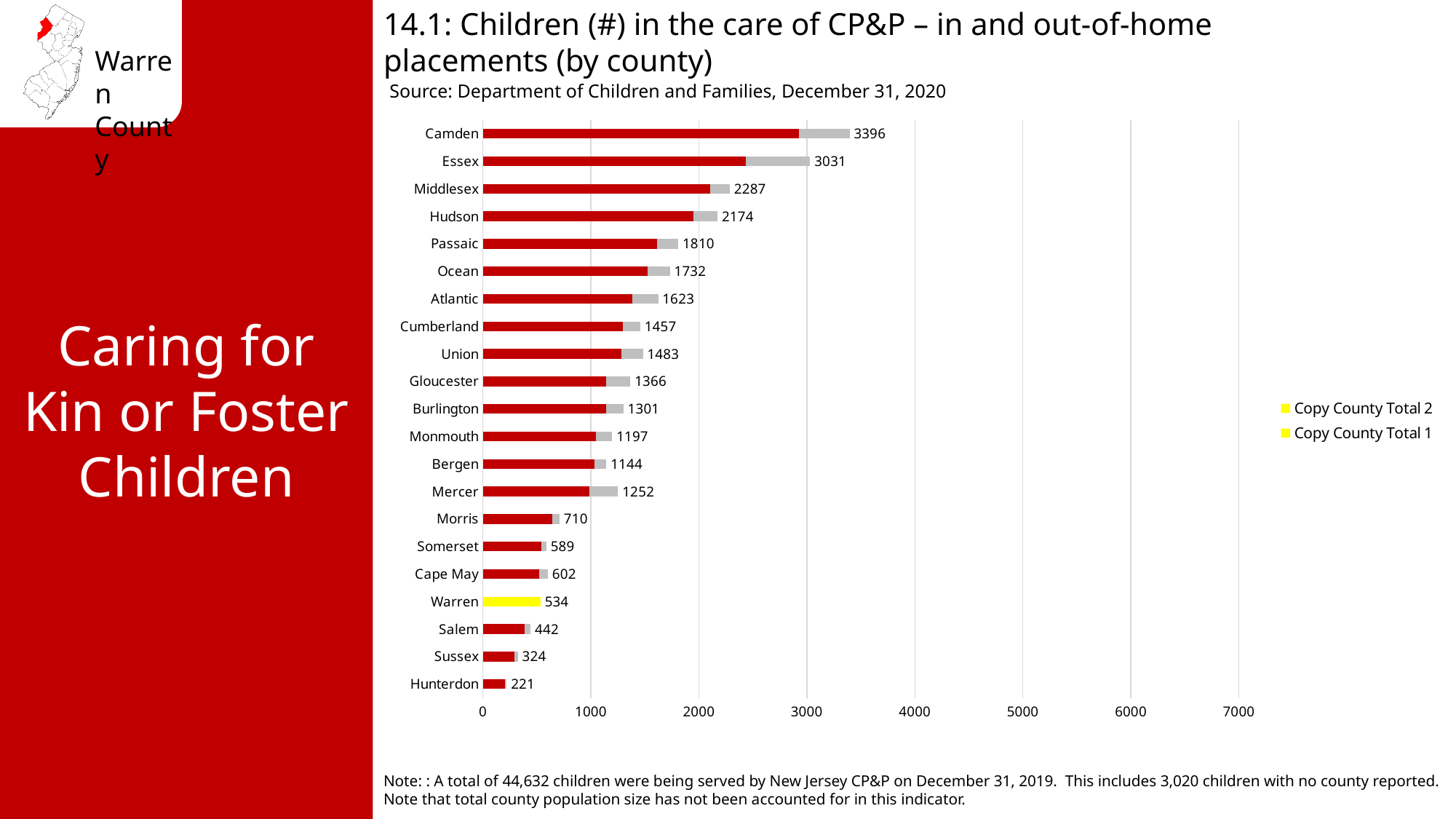
Is the red (first) segment of the Camden bar greater or less than 2000? greater Which has the larger labelled total, Union or Cumberland? Union How many series does the legend list? 2 What value is labelled for Mercer? 1252 Which county has the highest total number of children in the care of CP&P? Camden What kind of chart is shown on the slide? Bar chart What is the difference between the totals for Camden and Essex? 365 Which has the larger labelled total, Mercer or Bergen? Mercer Which county has the lowest total number of children in the care of CP&P? Hunterdon What value is labelled for Warren County? 534 What is the total number of children in the care of CP&P shown for Camden? 3396 How many counties are listed on the chart? 21